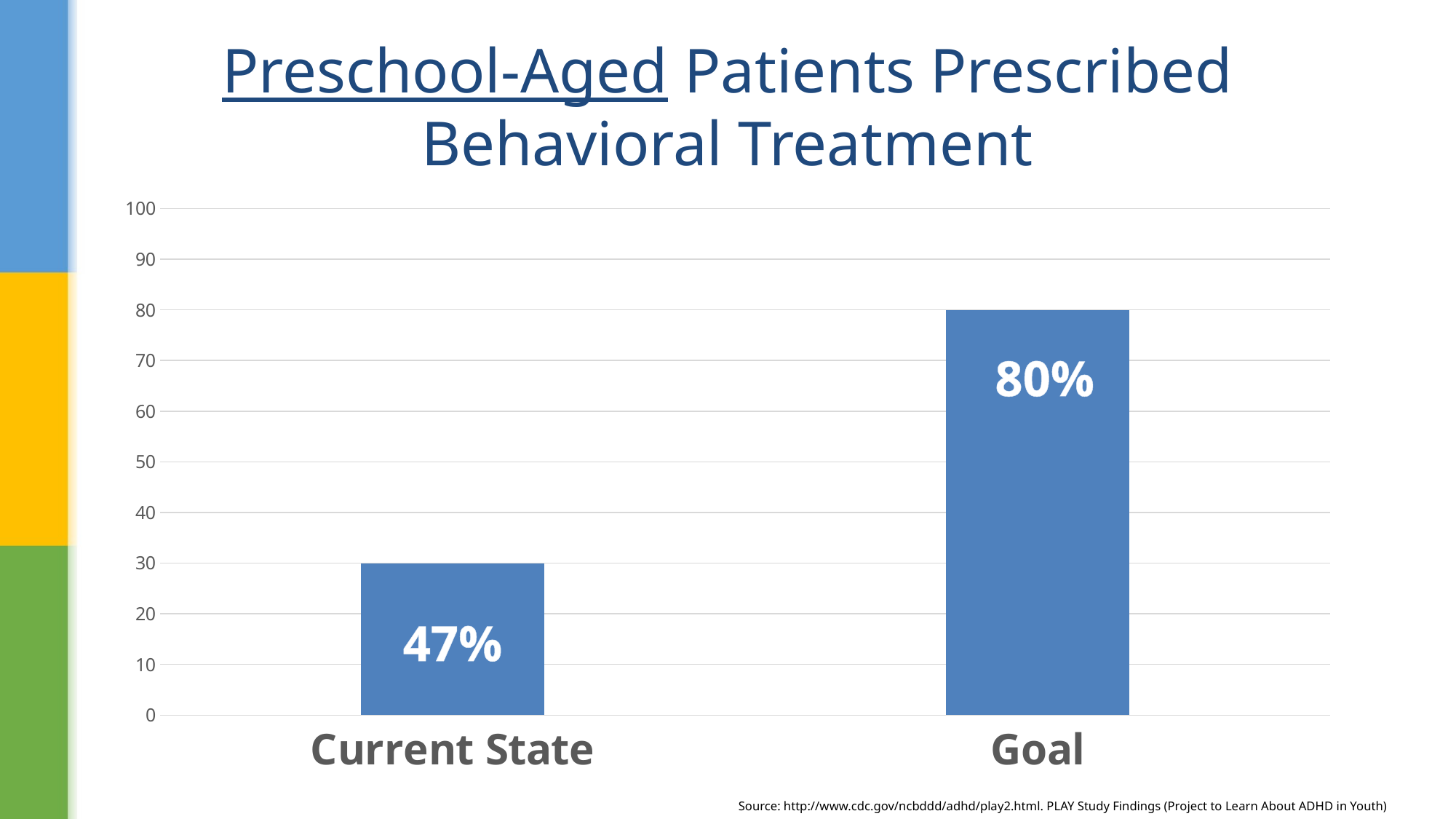
What is the title of the chart? Preschool-Aged Patients Prescribed Behavioral Treatment Which category has the lowest value? Current State How many categories are shown on the x axis? 2 What is the maximum value shown on the y axis? 100 Which category has the higher value, Current State or Goal? Goal What value is shown for Current State? 47% Which category has the highest value? Goal Is the value for Goal greater or less than 70? greater What value is shown for Goal? 80% What kind of chart is shown on the slide? Bar chart What is the difference between the Goal value and the Current State value? 33%